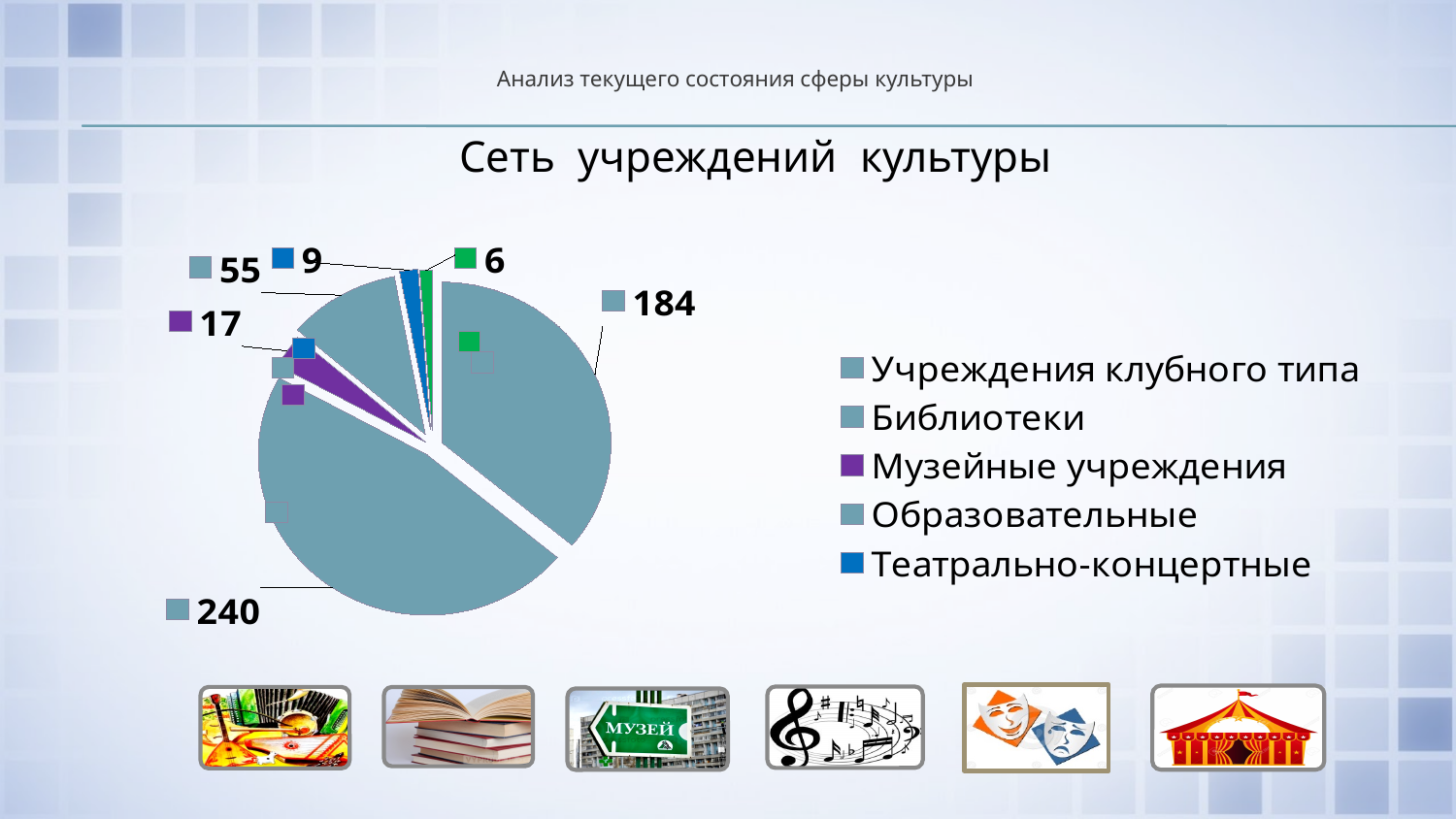
How many entries does the legend list? 5 What is the total of all the values shown on the pie chart? 511 What is the difference between the two largest slices, 240 and 184? 56 What is the smallest value shown on the pie chart? 6 What is the difference between the value for Музейные учреждения and the value for Театрально-концертные? 8 What kind of chart is shown on the slide? pie chart What is the title of the chart? Сеть учреждений культуры Which is larger: the slice labelled 55 or the slice labelled 17? 55 What is the value for Театрально-концертные? 9 What is the value for Музейные учреждения? 17 What is the largest value shown on the pie chart? 240 How many slices does the pie chart have? 6